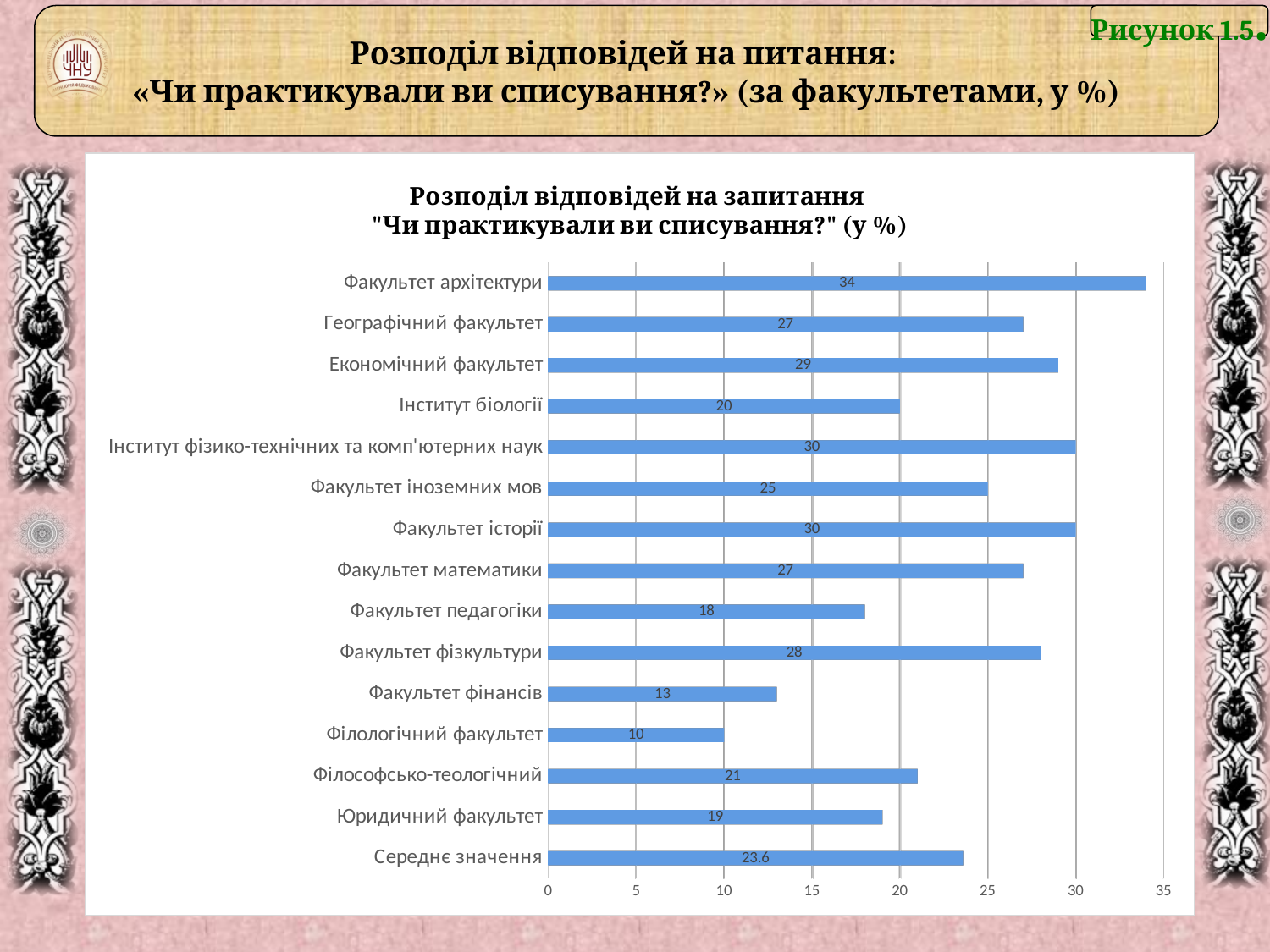
Which category has the highest value? Факультет архітектури Which category has the lowest value? Філологічний факультет Which is larger, the value for Економічний факультет or the value for Географічний факультет? Економічний факультет What kind of chart is shown on the slide? bar chart What is the value for Факультет архітектури? 34 What is the value for Середнє значення? 23.6 Is the value for Факультет педагогіки greater or less than 20? less What is the value for Філологічний факультет? 10 How many categories are shown on the chart? 15 What is the value for Інститут фізико-технічних та комп'ютерних наук? 30 What is the difference between the values for Факультет архітектури and Факультет фінансів? 21 What is the maximum value shown on the horizontal axis? 35